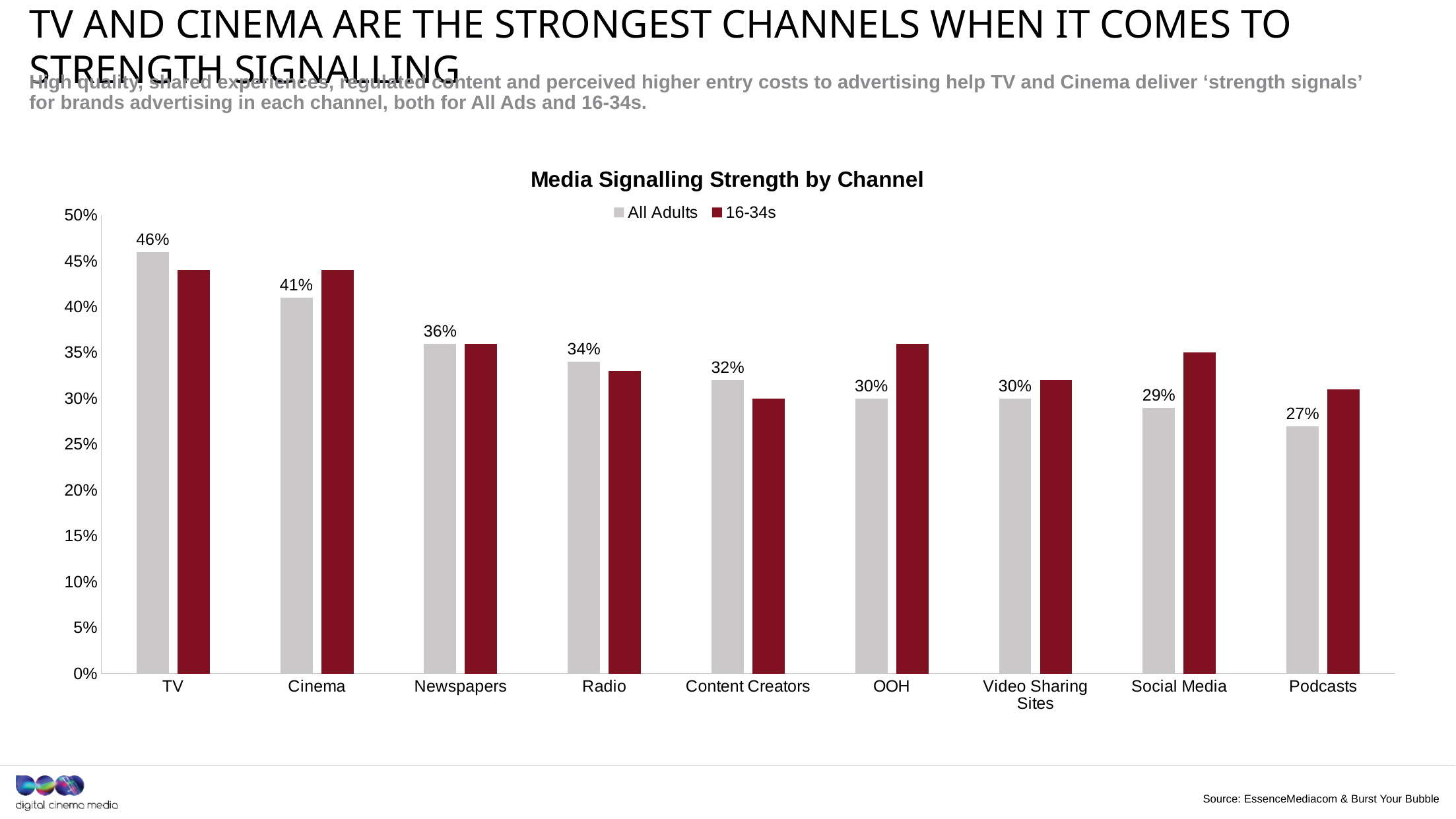
Which channel has the lowest All Adults value? Podcasts Is the 16-34s value for Podcasts greater or less than 25%? greater How many channels are shown on the x axis of the chart? 9 How many series does the chart's legend list? 2 Do the All Adults values rise or fall from left to right across the channels? fall What is the All Adults value for Cinema? 41% What is the All Adults value for TV in the Media Signalling Strength by Channel chart? 46% Is the 16-34s value for Cinema greater or less than 40%? greater What is the All Adults value for Podcasts? 27% What is the difference between the All Adults values for TV and Podcasts? 19 percentage points Which channel has the highest All Adults value? TV For OOH, which is larger: the All Adults value or the 16-34s value? 16-34s